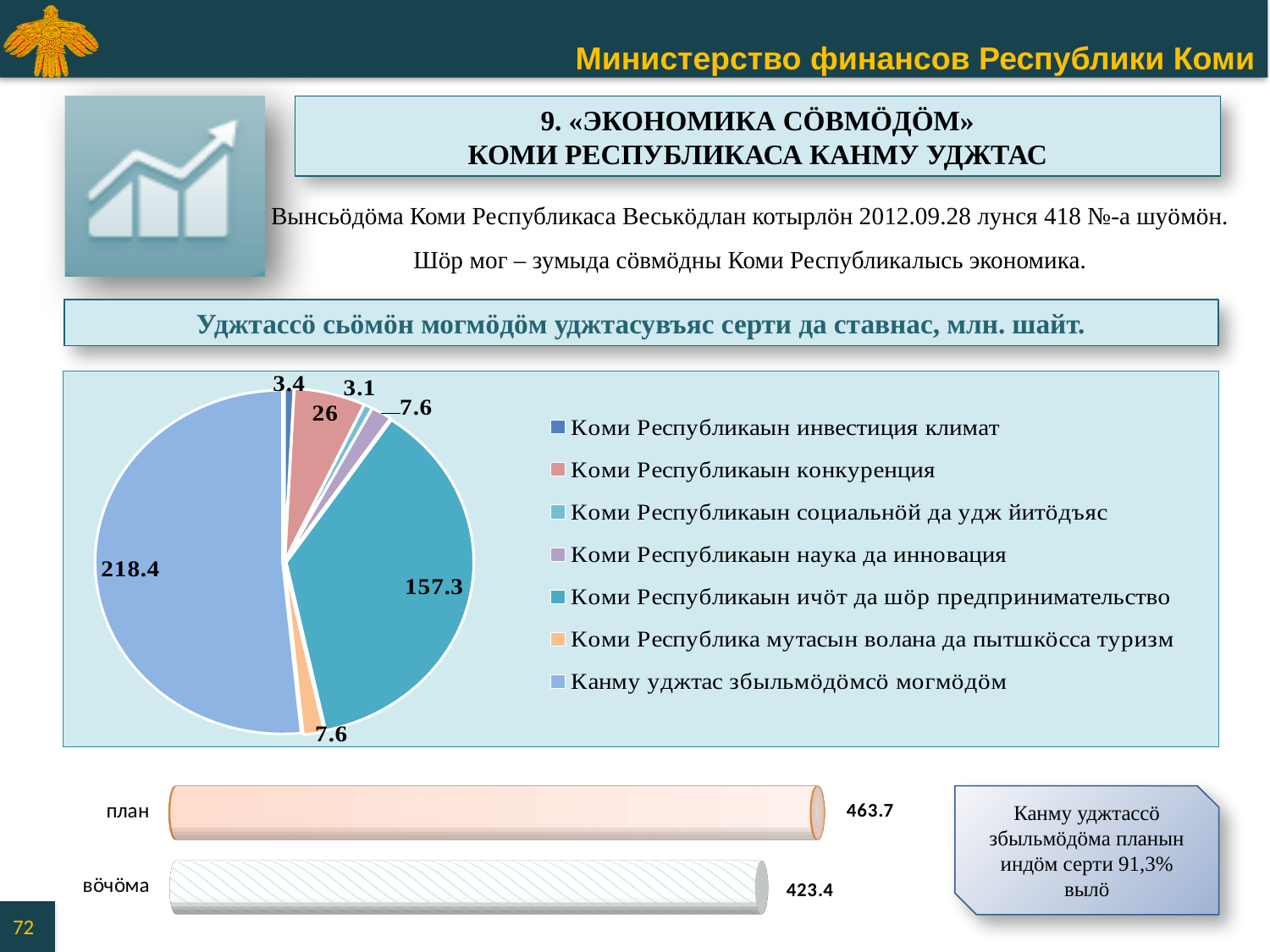
In the bar chart at the bottom of the slide, what is the value for план? 463.7 What kind of chart is the upper chart on the slide? Pie chart In the pie chart, which category has the largest slice? Канму уджтас збыльмöдöмсö могмöдöм In the bar chart at the bottom of the slide, what is the difference between план and вöчöма? 40.3 In the pie chart, what is the value for Коми Республикаын ичöт да шöр предпринимательство? 157.3 In the pie chart, what is the difference between the values for Канму уджтас збыльмöдöмсö могмöдöм and Коми Республикаын ичöт да шöр предпринимательство? 61.1 In the pie chart, what is the value for Канму уджтас збыльмöдöмсö могмöдöм? 218.4 How many entries does the legend of the pie chart list? 7 In the bar chart at the bottom of the slide, what is the value for вöчöма? 423.4 In the pie chart, what is the value for Коми Республикаын конкуренция? 26 In the pie chart, which category has the smallest slice? Коми Республикаын социальнöй да удж йитöдъяс What kind of chart is the lower chart on the slide? Bar chart